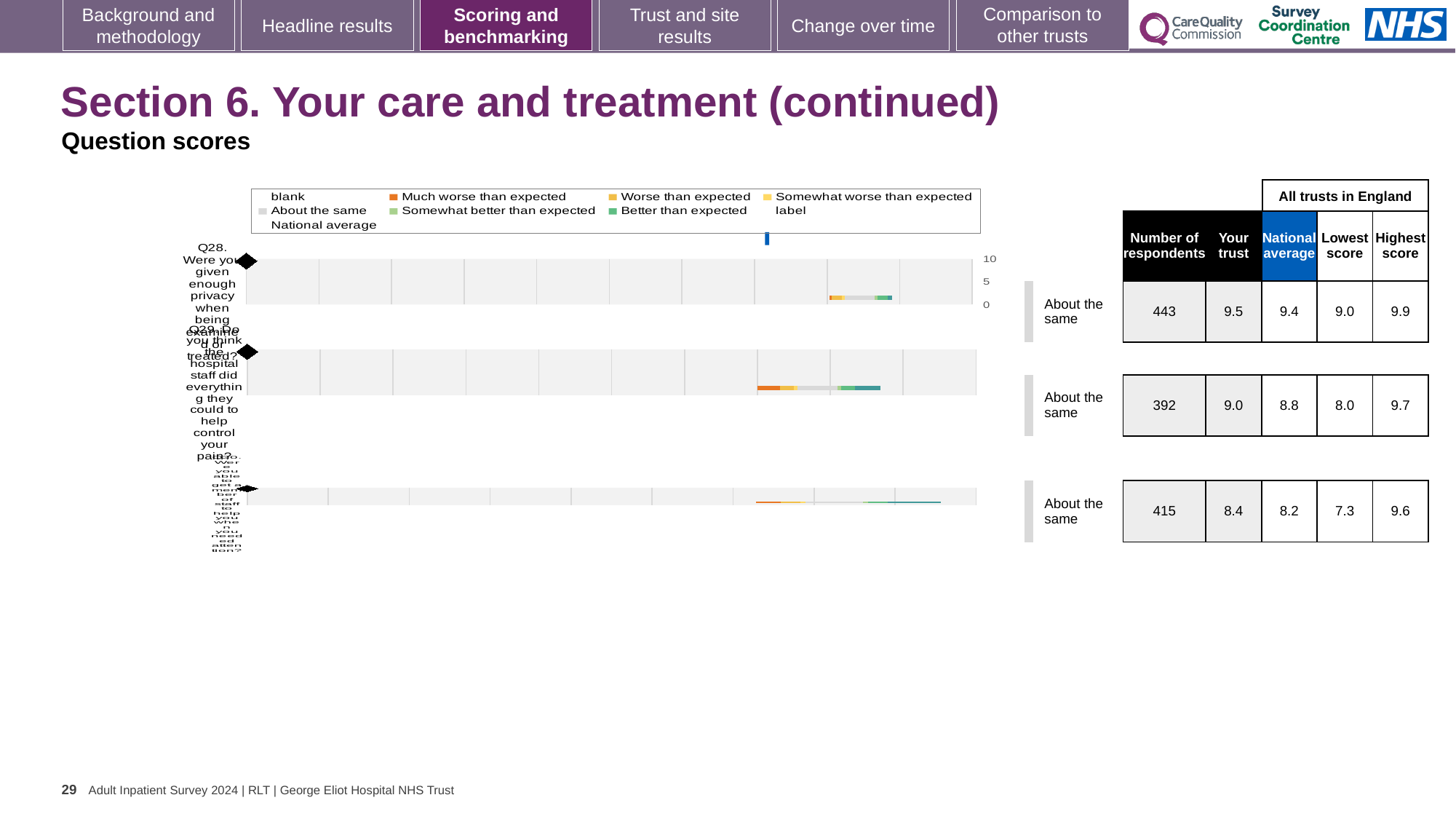
What benchmark category is shown for Q29? About the same For Q29, which is larger: the 'Your trust' score or the national average? Your trust What kind of chart is used to show the question scores on this slide? bar chart What is the 'Your trust' score for Q28 (privacy when being examined or treated)? 9.5 What is the national average score for Q29 (staff did everything to help control your pain)? 8.8 Which question has the lowest 'Lowest score' across all trusts in England? Q30 What is the highest score across all trusts in England for Q30? 9.6 Which question has the highest 'Your trust' score? Q28 How many questions (rows) are plotted in the chart? 3 What is the difference between the 'Your trust' score and the national average for Q28? 0.1 How many respondents answered Q30? 415 What is the difference between the highest score and the lowest score for Q30? 2.3